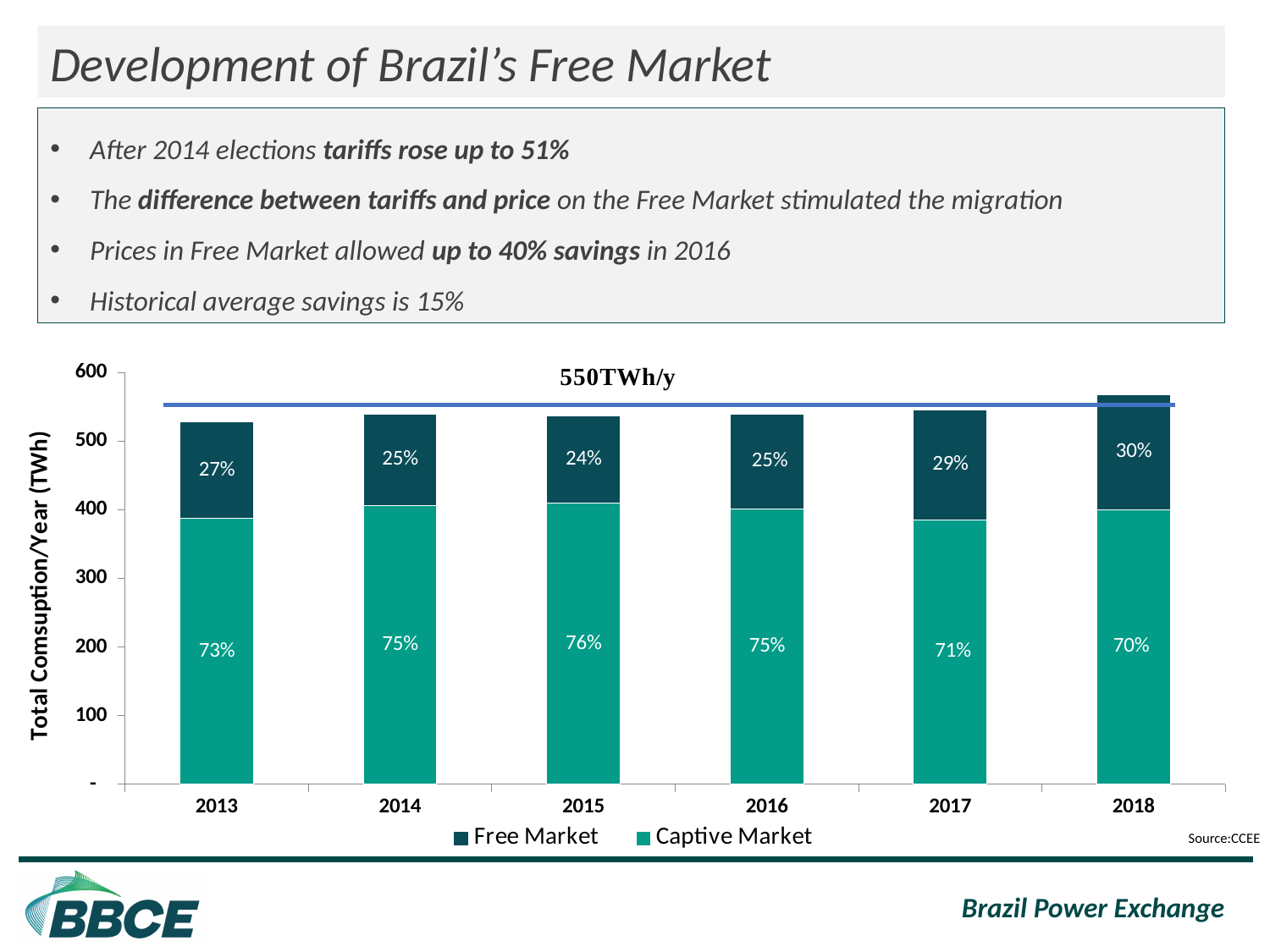
In which year is the Free Market share the highest? 2018 What percentage of total consumption did the Free Market account for in 2013? 27% How many years are shown on the x axis of the chart? 6 What is the Free Market share shown for 2018? 30% How many series does the chart legend list? 2 Is the total consumption bar for 2013 greater or less than 500 TWh? greater What type of chart is used to show total consumption per year? Stacked bar chart What is the Captive Market share shown for 2017? 71% In which year is the Free Market share the lowest? 2015 What is the Captive Market share shown for 2015? 76% Which year had a larger Free Market share, 2016 or 2017? 2017 By how many percentage points did the Free Market share in 2018 exceed that in 2013? 3 percentage points